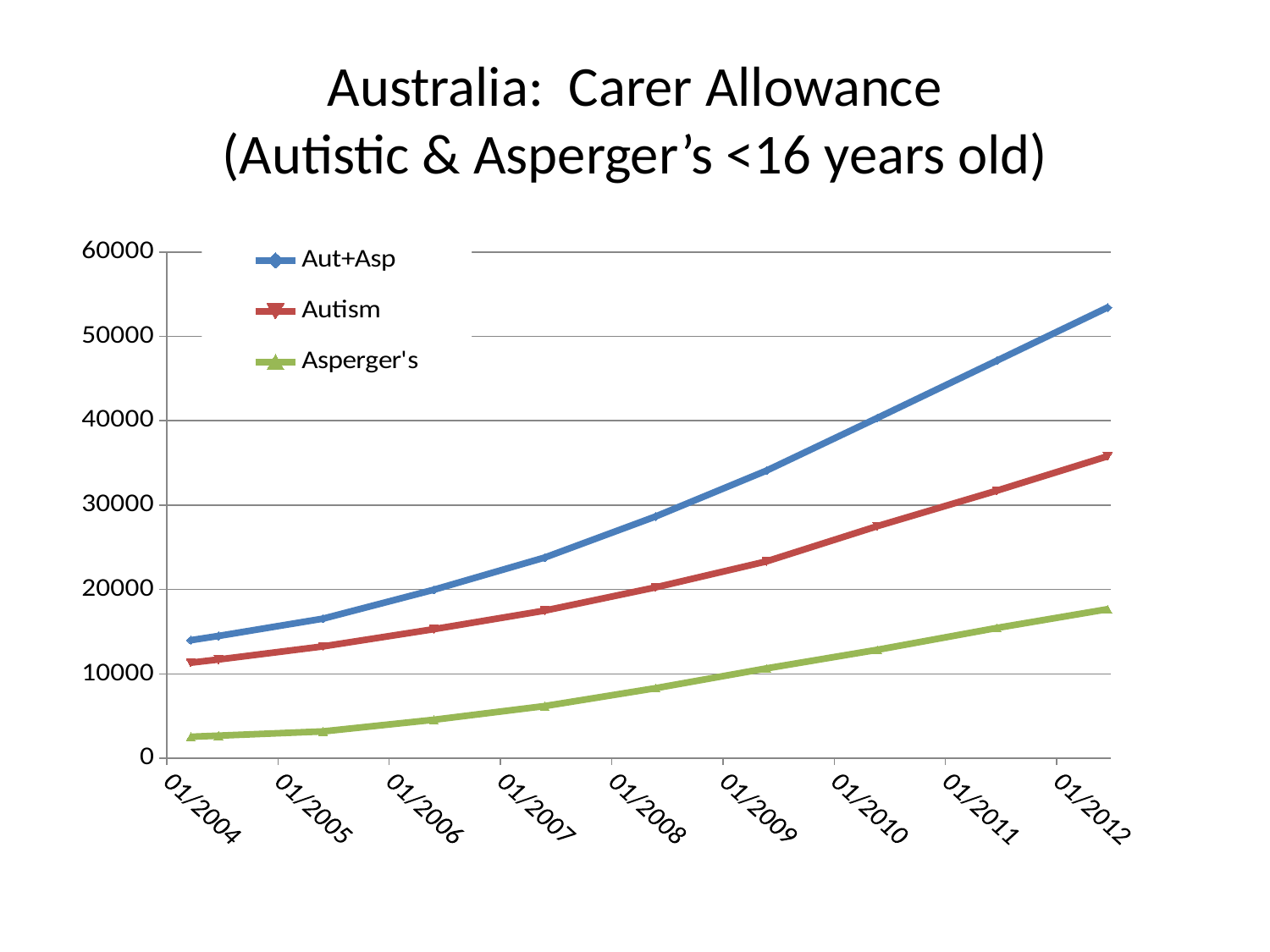
Do the values for the Autism series rise or fall from 01/2004 to 01/2012? rise Which series has the highest values across the whole period? Aut+Asp How many series does the legend list? 3 Is the value for Asperger's at 01/2004 greater or less than 10000? less Which series has the lowest values across the whole period? Asperger's Which series is shown in green in the legend? Asperger's Is the value for Asperger's at 01/2012 greater or less than 20000? less At 01/2012, which is larger: the value for Autism or the value for Asperger's? Autism What type of chart is shown on the slide? line chart Is the value for Aut+Asp at 01/2012 greater or less than 50000? greater What is the title of the chart? Australia: Carer Allowance (Autistic & Asperger's <16 years old)